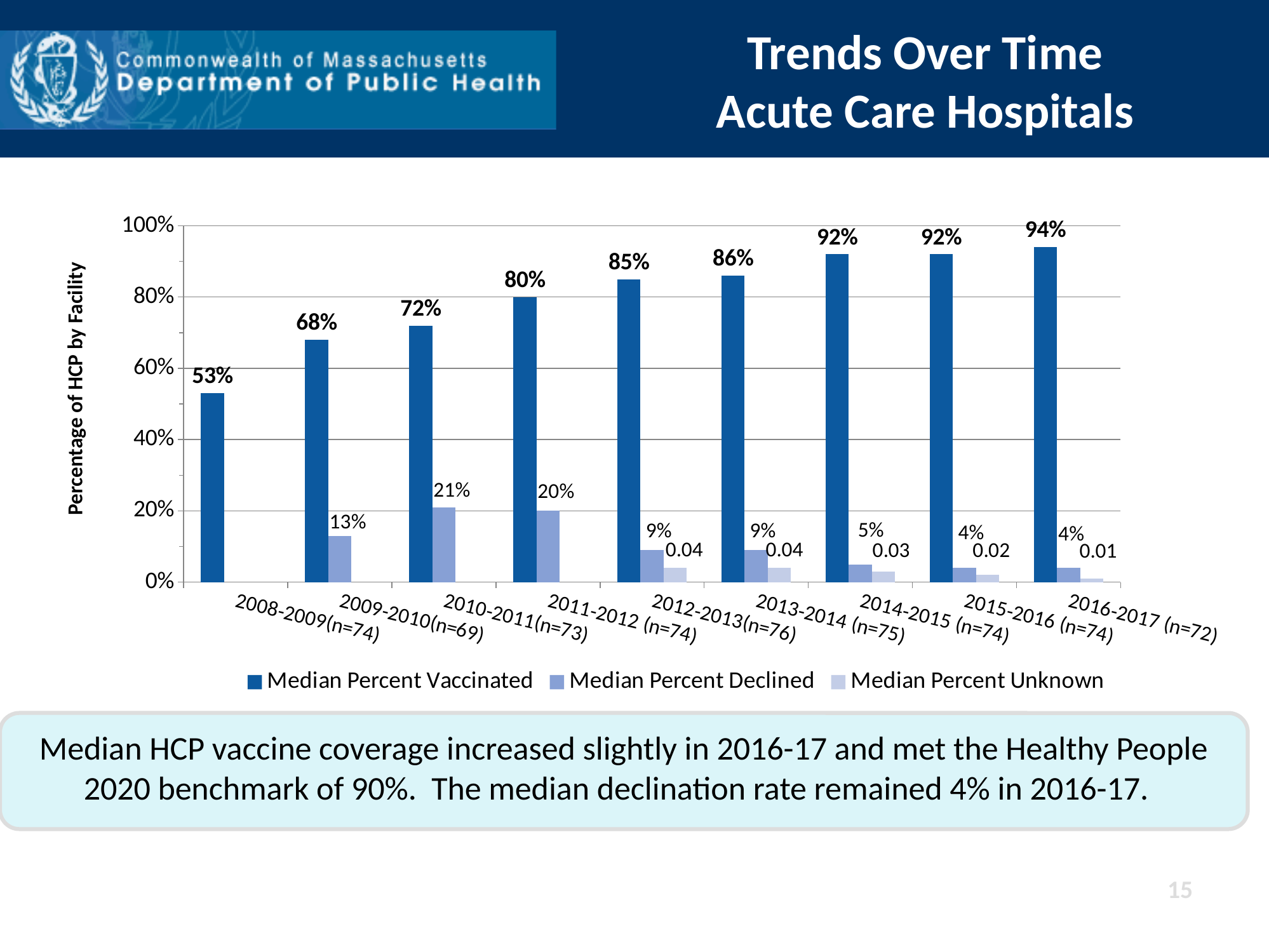
What is the Median Percent Declined for 2010-2011 (n=73)? 21% Which season has the highest Median Percent Vaccinated? 2016-2017 (n=72) How many seasons are shown on the x axis? 9 What is the Median Percent Unknown for 2016-2017 (n=72)? 0.01 What kind of chart is shown on the slide? bar chart Which season has the lowest Median Percent Vaccinated? 2008-2009 (n=74) What is the difference in Median Percent Vaccinated between 2016-2017 (n=72) and 2008-2009 (n=74)? 41% How many series does the legend list? 3 Which is larger, the Median Percent Declined for 2010-2011 (n=73) or for 2011-2012 (n=74)? 2010-2011 (n=73) What is the Median Percent Vaccinated for 2008-2009 (n=74)? 53% Is the Median Percent Vaccinated for 2011-2012 (n=74) greater or less than 60%? greater Does the Median Percent Declined rise or fall from 2010-2011 (n=73) to 2016-2017 (n=72)? fall